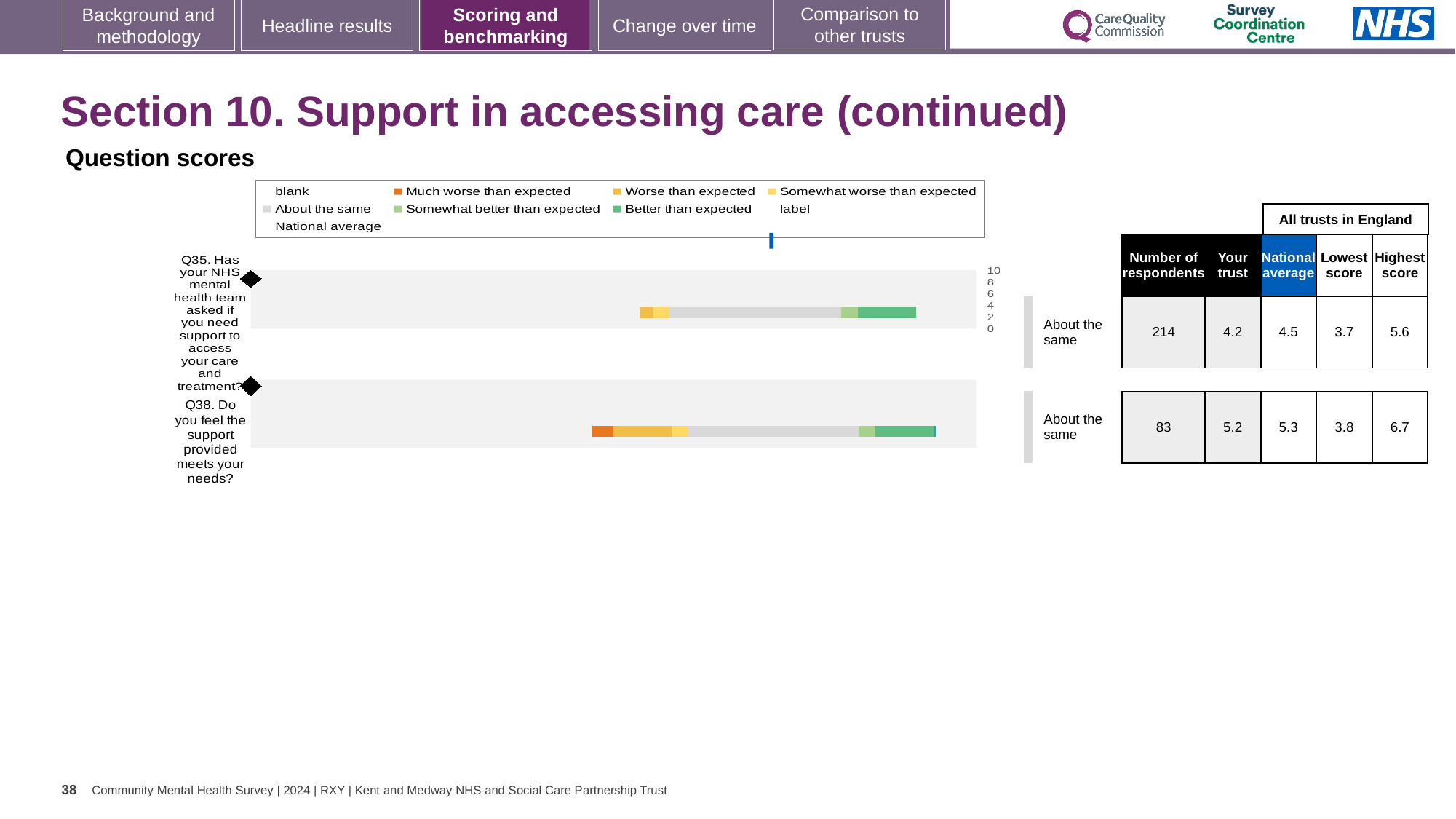
In the question scores chart legend, what colour represents 'Much worse than expected'? orange In the table beside the chart, what is the 'Your trust' score for Q38? 5.2 How many questions are plotted as bars in the question scores chart? 2 In the table beside the chart, what is the highest score across all trusts in England for Q38? 6.7 For Q38, is the 'Your trust' score higher or lower than the national average in the table? lower In the table beside the chart, what is the national average for Q35? 4.5 In the question scores chart legend, what colour represents 'About the same'? grey What is the difference between the highest and lowest scores for Q38 in the table? 2.9 In the table beside the chart, what is the lowest score across all trusts in England for Q35? 3.7 What kind of chart is used to show the question scores on this slide? bar chart In the table beside the chart, how many respondents are listed for Q35? 214 Which question has more respondents in the table, Q35 or Q38? Q35